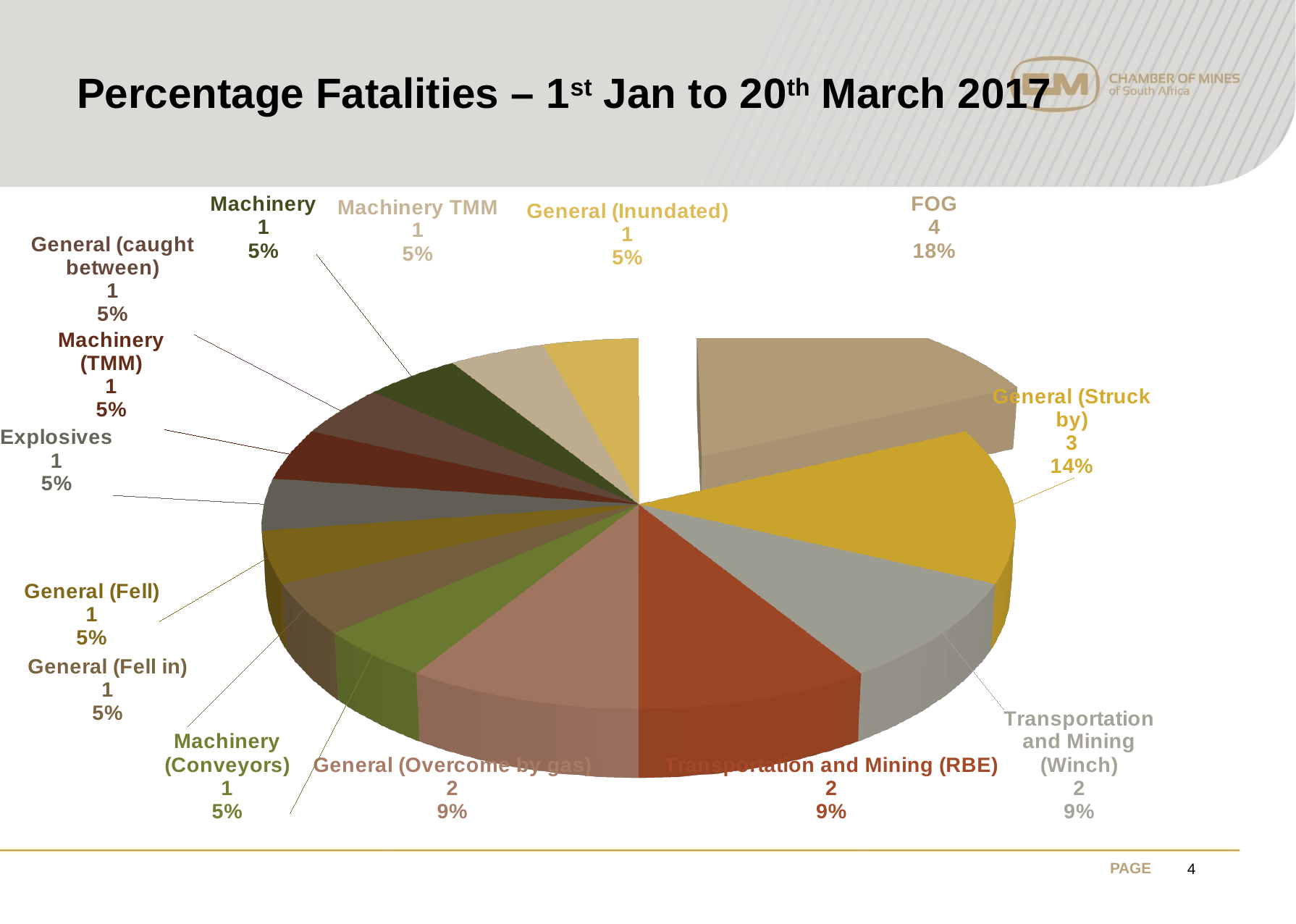
What share of the pie does General (Struck by) represent? 14% What percentage is shown for General (Overcome by gas)? 9% What percentage of fatalities is attributed to FOG? 18% What is the total number of fatalities across all categories in the chart? 22 What is the difference in the number of fatalities between FOG and Transportation and Mining (Winch)? 2 What is the title of the slide? Percentage Fatalities – 1st Jan to 20th March 2017 Which category has the largest share of fatalities? FOG How many categories are shown in the pie chart? 14 How many fatalities are shown for General (Struck by)? 3 How many fatalities are shown for Transportation and Mining (RBE)? 2 What kind of chart is shown on the slide? pie chart Which is larger, the share for FOG or the share for General (Struck by)? FOG